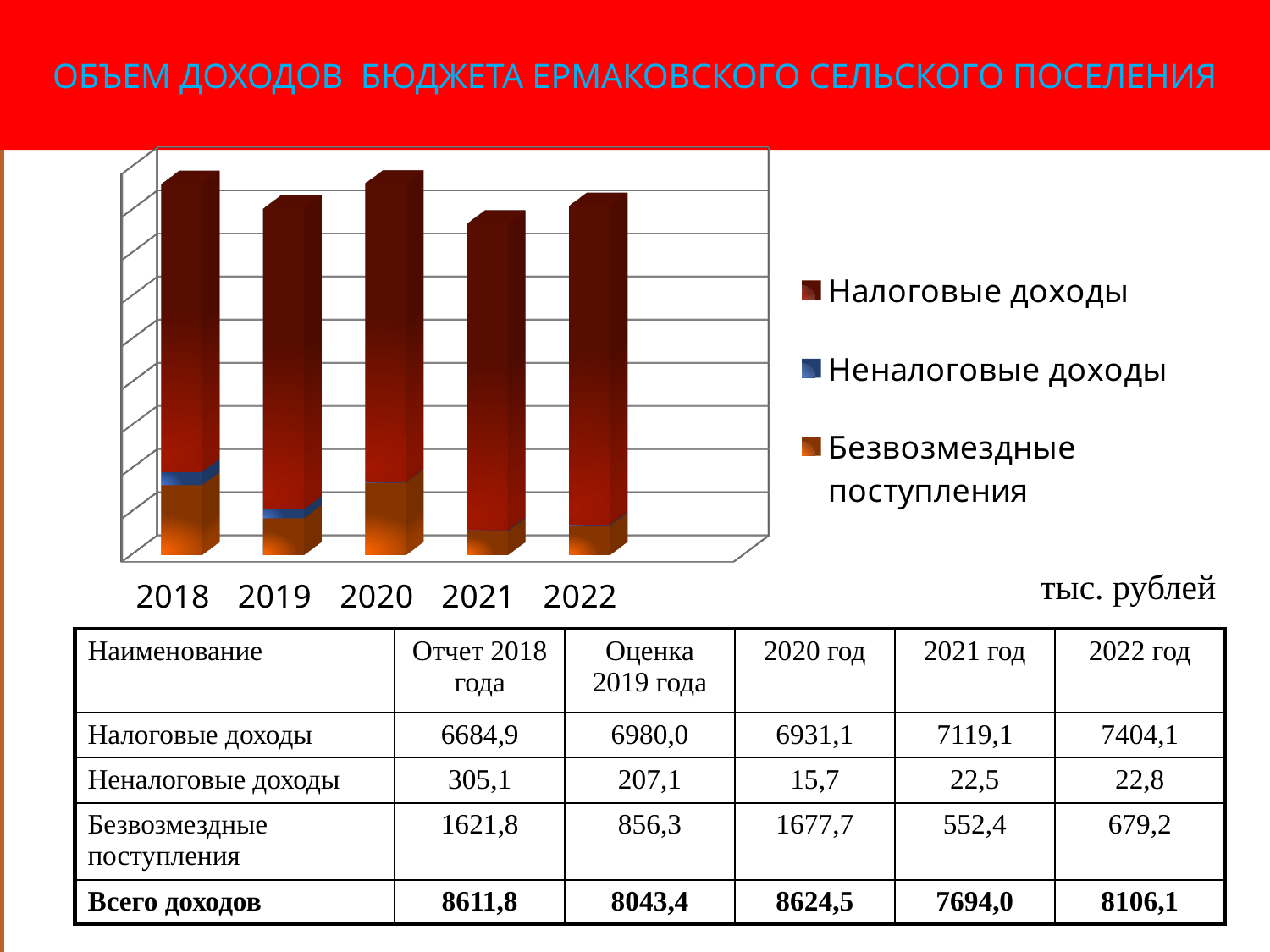
What is the value of Безвозмездные поступления for 2020 according to the slide? 1677,7 Which year has the lowest total bar on the chart? 2021 How many years (categories) are plotted on the chart? 5 Which series is shown in blue on the chart? Неналоговые доходы Is the total bar for 2019 taller or shorter than the total bar for 2021? taller Which series is shown in dark red on the chart? Налоговые доходы How many series does the chart legend list? 3 Do the values of Налоговые доходы rise or fall from 2020 to 2022? rise What is the total income (Всего доходов) for 2021 according to the slide? 7694,0 What is the difference between Налоговые доходы in 2022 and in 2018 according to the slide? 719,2 What is the value of Налоговые доходы for 2022 according to the slide? 7404,1 What kind of chart is shown on the slide? Stacked bar chart